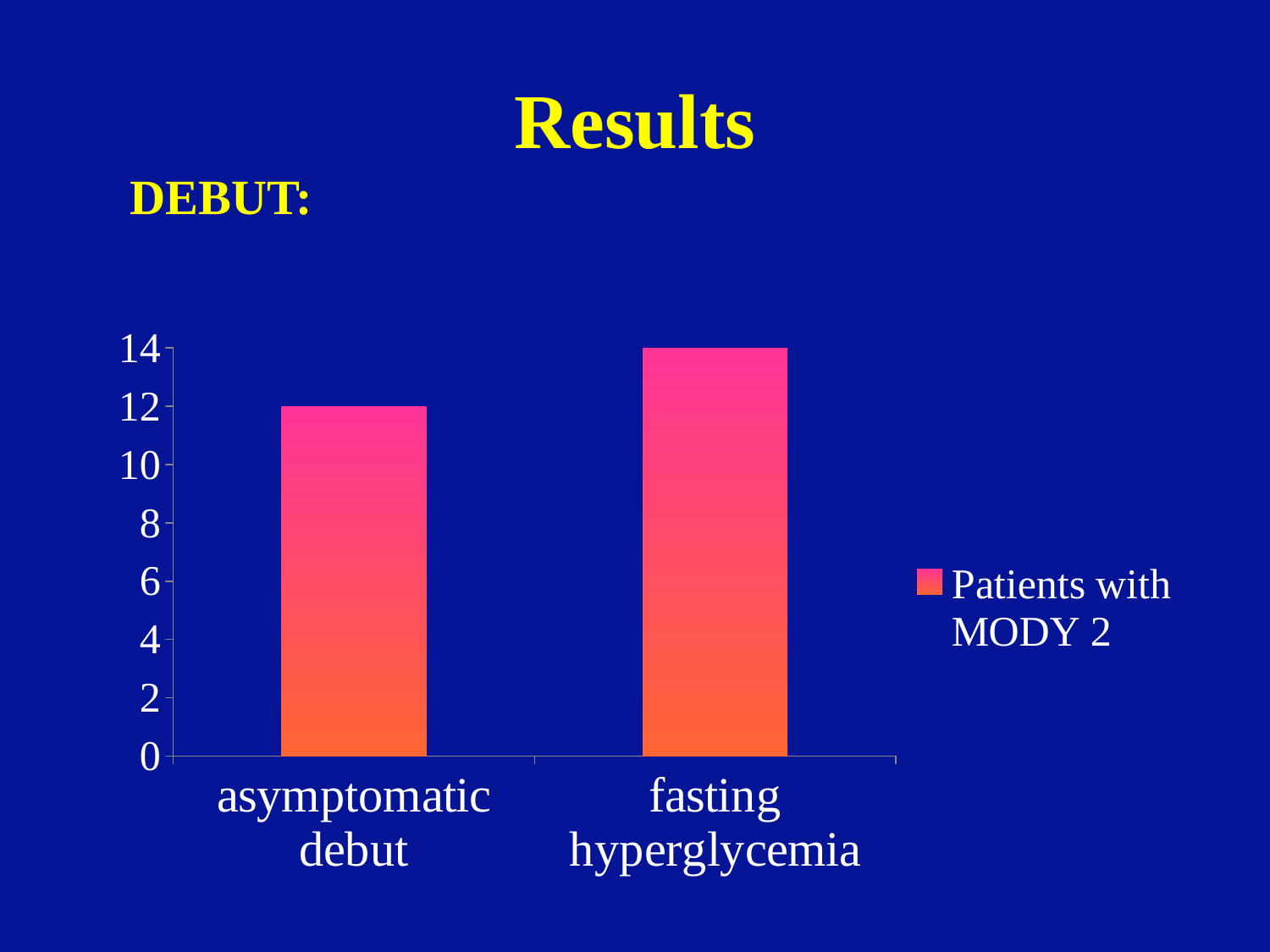
What is the value for fasting hyperglycemia? 14 How many series does the legend list? 1 What kind of chart is shown on the slide? bar chart Is the value for asymptomatic debut greater or less than 10? greater What is the difference between the values for fasting hyperglycemia and asymptomatic debut? 2 What is the title of the slide? Results Which category has the highest value? fasting hyperglycemia How many categories are plotted on the chart? 2 Which is larger, the value for asymptomatic debut or the value for fasting hyperglycemia? fasting hyperglycemia What series name is shown in the legend? Patients with MODY 2 What is the value for asymptomatic debut? 12 Which category has the lowest value? asymptomatic debut